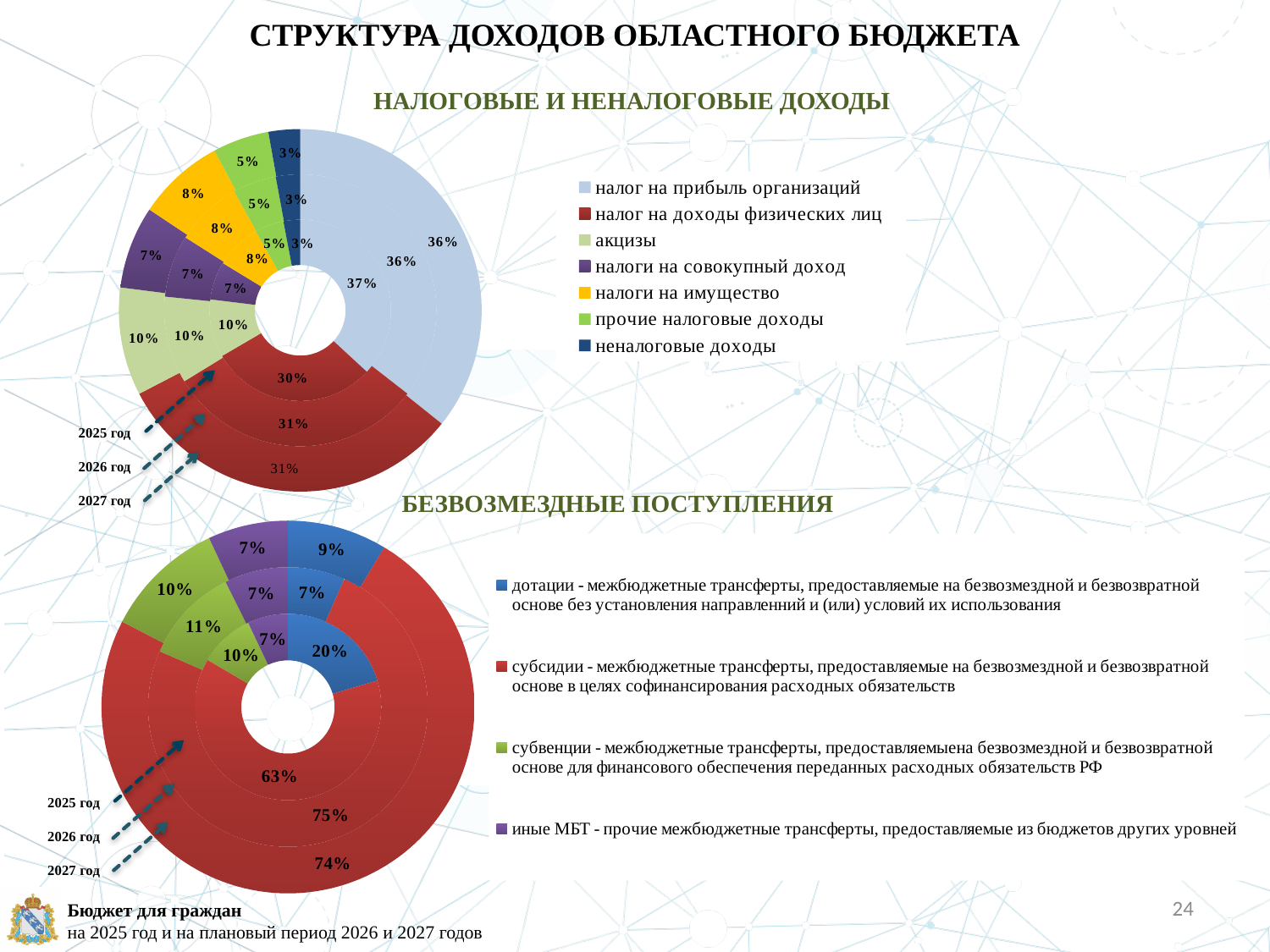
In the 'НАЛОГОВЫЕ И НЕНАЛОГОВЫЕ ДОХОДЫ' chart, which category has the smallest share in the innermost ring (2025 год)? неналоговые доходы How many series does the legend of the 'БЕЗВОЗМЕЗДНЫЕ ПОСТУПЛЕНИЯ' chart list? 4 What type of chart is used for 'НАЛОГОВЫЕ И НЕНАЛОГОВЫЕ ДОХОДЫ'? Doughnut (pie) chart In the 'НАЛОГОВЫЕ И НЕНАЛОГОВЫЕ ДОХОДЫ' chart, what is the difference between 'налог на прибыль организаций' (37%) and 'налог на доходы физических лиц' (30%) in the innermost ring (2025 год)? 7% In the 'НАЛОГОВЫЕ И НЕНАЛОГОВЫЕ ДОХОДЫ' chart, what is the share of 'налог на доходы физических лиц' in the innermost ring (2025 год)? 30% In the 'НАЛОГОВЫЕ И НЕНАЛОГОВЫЕ ДОХОДЫ' chart, which category has the largest share in the innermost ring (2025 год)? налог на прибыль организаций In the 'БЕЗВОЗМЕЗДНЫЕ ПОСТУПЛЕНИЯ' chart, what is the share of 'субсидии' in the outermost ring (2027 год)? 74% In the 'БЕЗВОЗМЕЗДНЫЕ ПОСТУПЛЕНИЯ' chart, what is the share of 'субсидии' in the innermost ring (2025 год)? 63% In the 'БЕЗВОЗМЕЗДНЫЕ ПОСТУПЛЕНИЯ' chart, which is larger in the innermost ring (2025 год): 'дотации' or 'субвенции'? дотации In the 'БЕЗВОЗМЕЗДНЫЕ ПОСТУПЛЕНИЯ' chart, what is the share of 'дотации' in the innermost ring (2025 год)? 20% How many series does the legend of the 'НАЛОГОВЫЕ И НЕНАЛОГОВЫЕ ДОХОДЫ' chart list? 7 In the 'НАЛОГОВЫЕ И НЕНАЛОГОВЫЕ ДОХОДЫ' chart, what is the share of 'налог на прибыль организаций' in the innermost ring (2025 год)? 37%